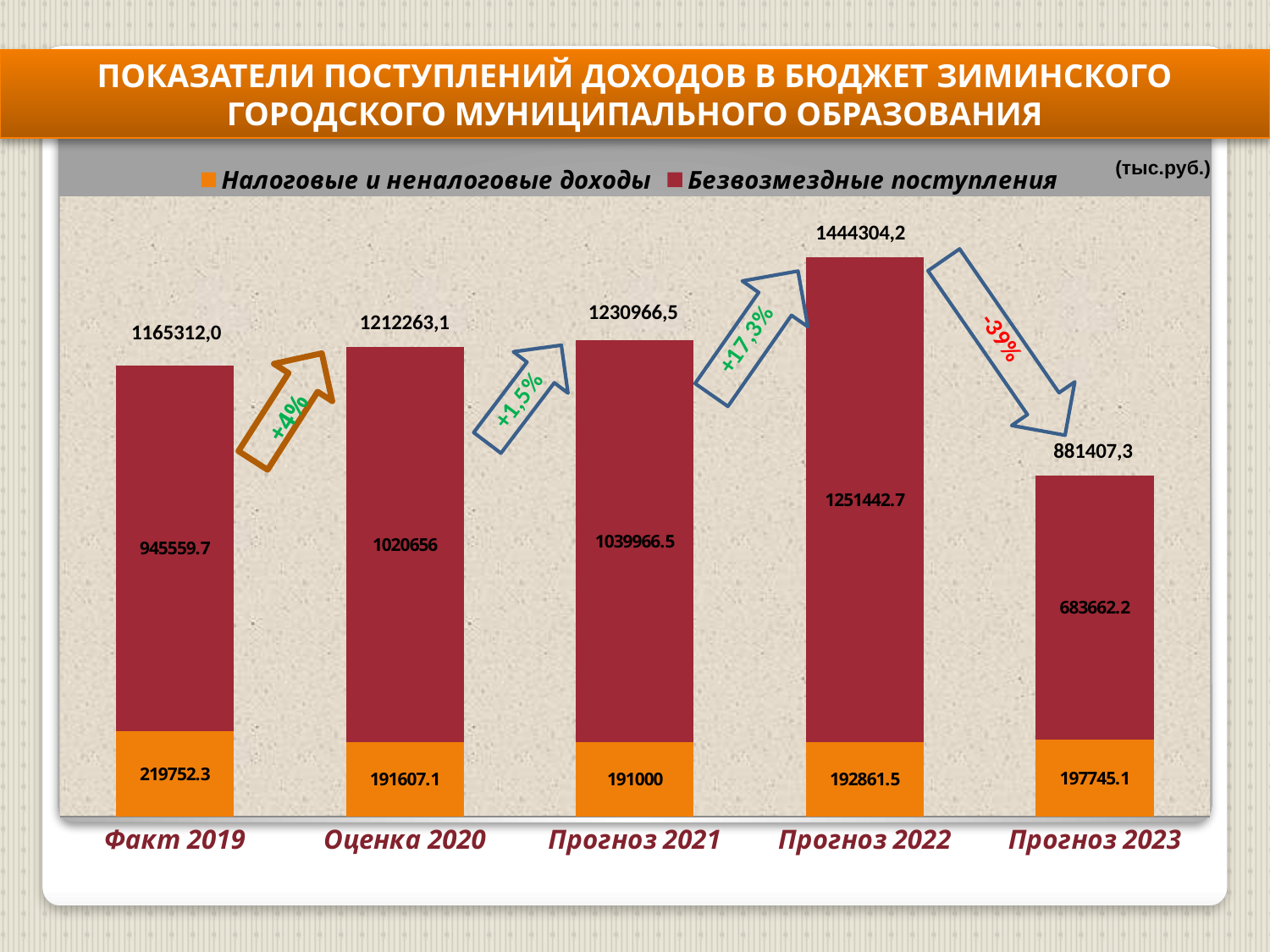
How many categories are shown along the x axis? 5 Which category has the highest total? Прогноз 2022 How many series does the legend list? 2 What is the value of Налоговые и неналоговые доходы for Факт 2019? 219752.3 What is the difference between the total for Прогноз 2022 and the total for Прогноз 2023? 562896,9 Which is larger: Безвозмездные поступления for Прогноз 2021 or for Оценка 2020? Прогноз 2021 What is the value of Безвозмездные поступления for Прогноз 2022? 1251442.7 Which category has the lowest total? Прогноз 2023 What unit is indicated in the top right corner of the chart? тыс.руб. What type of chart is shown on the slide? Stacked bar chart What is the total of the stacked bar for Оценка 2020? 1212263,1 What is the value of Безвозмездные поступления for Прогноз 2023? 683662.2